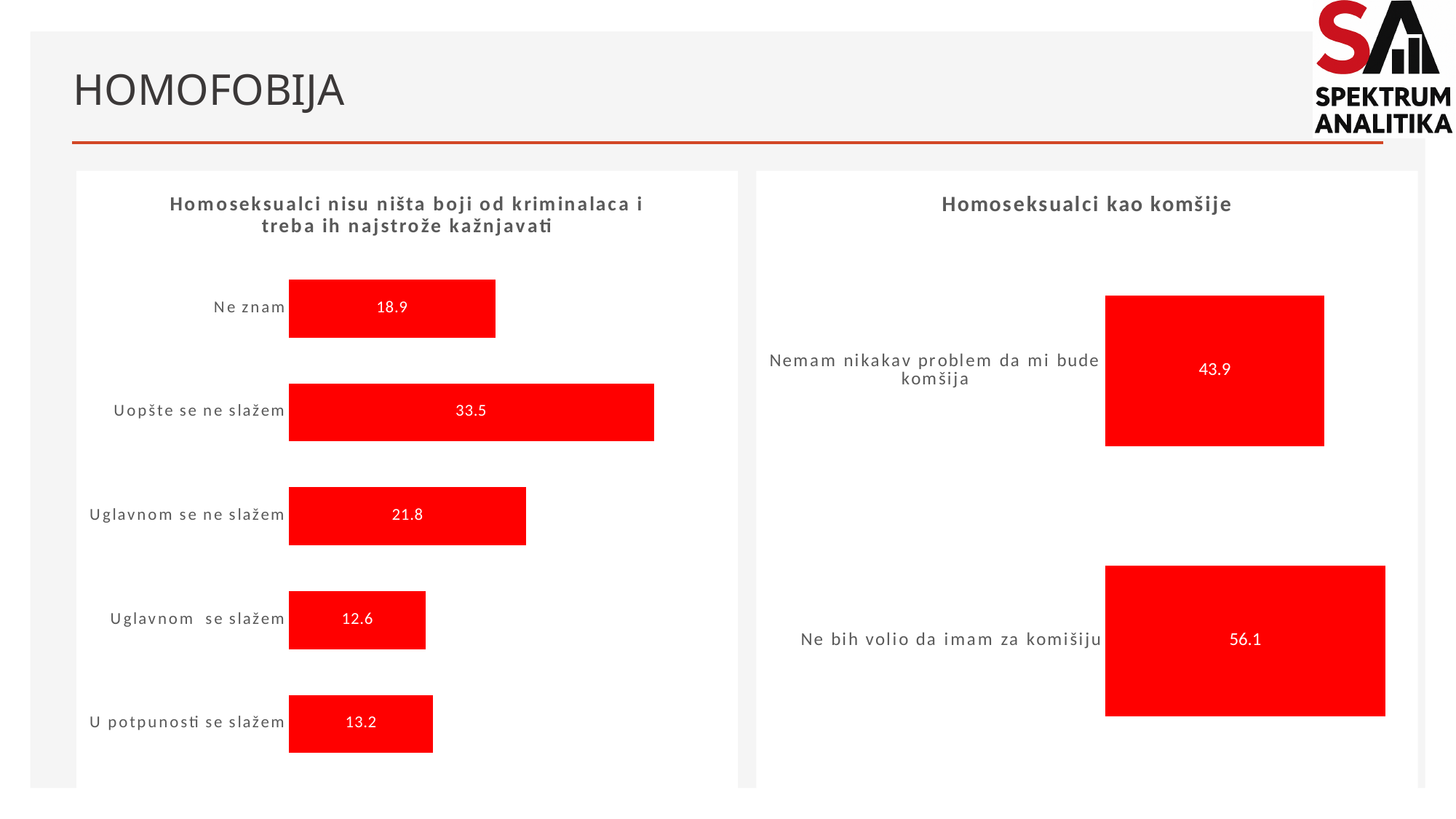
In the left chart 'Homoseksualci nisu ništa boji od kriminalaca i treba ih najstrože kažnjavati', which category has the highest value? Uopšte se ne slažem In the right chart 'Homoseksualci kao komšije', what is the difference between the two categories? 12.2 In the right chart 'Homoseksualci kao komšije', which category has the larger value? Ne bih volio da imam za komišiju In the left chart 'Homoseksualci nisu ništa boji od kriminalaca i treba ih najstrože kažnjavati', how many categories are shown? 5 In the right chart 'Homoseksualci kao komšije', what is the value for 'Ne bih volio da imam za komišiju'? 56.1 What colour are the bars in the left chart 'Homoseksualci nisu ništa boji od kriminalaca i treba ih najstrože kažnjavati'? Red What type of chart is the right chart 'Homoseksualci kao komšije'? Bar chart In the left chart 'Homoseksualci nisu ništa boji od kriminalaca i treba ih najstrože kažnjavati', what is the value for 'Ne znam'? 18.9 In the left chart 'Homoseksualci nisu ništa boji od kriminalaca i treba ih najstrože kažnjavati', what is the difference between 'Uopšte se ne slažem' and 'Uglavnom se ne slažem'? 11.7 In the left chart 'Homoseksualci nisu ništa boji od kriminalaca i treba ih najstrože kažnjavati', what is the value for 'Uopšte se ne slažem'? 33.5 In the left chart 'Homoseksualci nisu ništa boji od kriminalaca i treba ih najstrože kažnjavati', which category has the lowest value? Uglavnom se slažem In the right chart 'Homoseksualci kao komšije', what is the value for 'Nemam nikakav problem da mi bude komšija'? 43.9